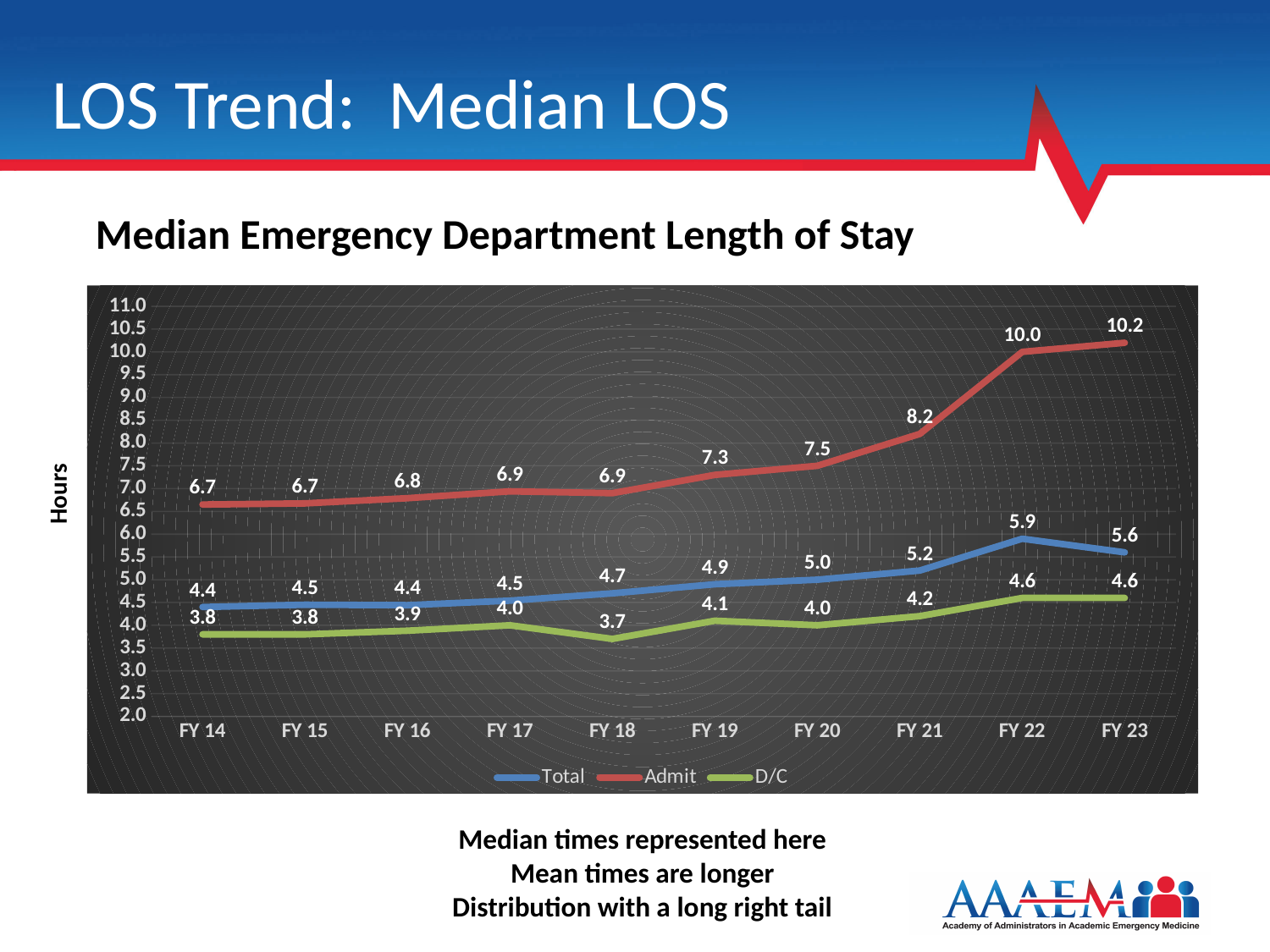
What kind of chart is shown on the slide? Line chart What is the Total median length of stay in FY 18? 4.7 How many fiscal years are shown on the x axis? 10 How many series does the legend list? 3 In which fiscal year is the Admit median length of stay highest? FY 23 Does the Admit series generally rise or fall from FY 14 to FY 23? Rise What is the Admit median length of stay in FY 23? 10.2 What is the difference between the Admit and Total median length of stay in FY 22? 4.1 Is the Admit value for FY 21 greater or less than 8.0? greater Which is larger, the Total value in FY 22 or the Total value in FY 23? FY 22 What is the D/C median length of stay in FY 21? 4.2 In which fiscal year is the D/C median length of stay lowest? FY 18